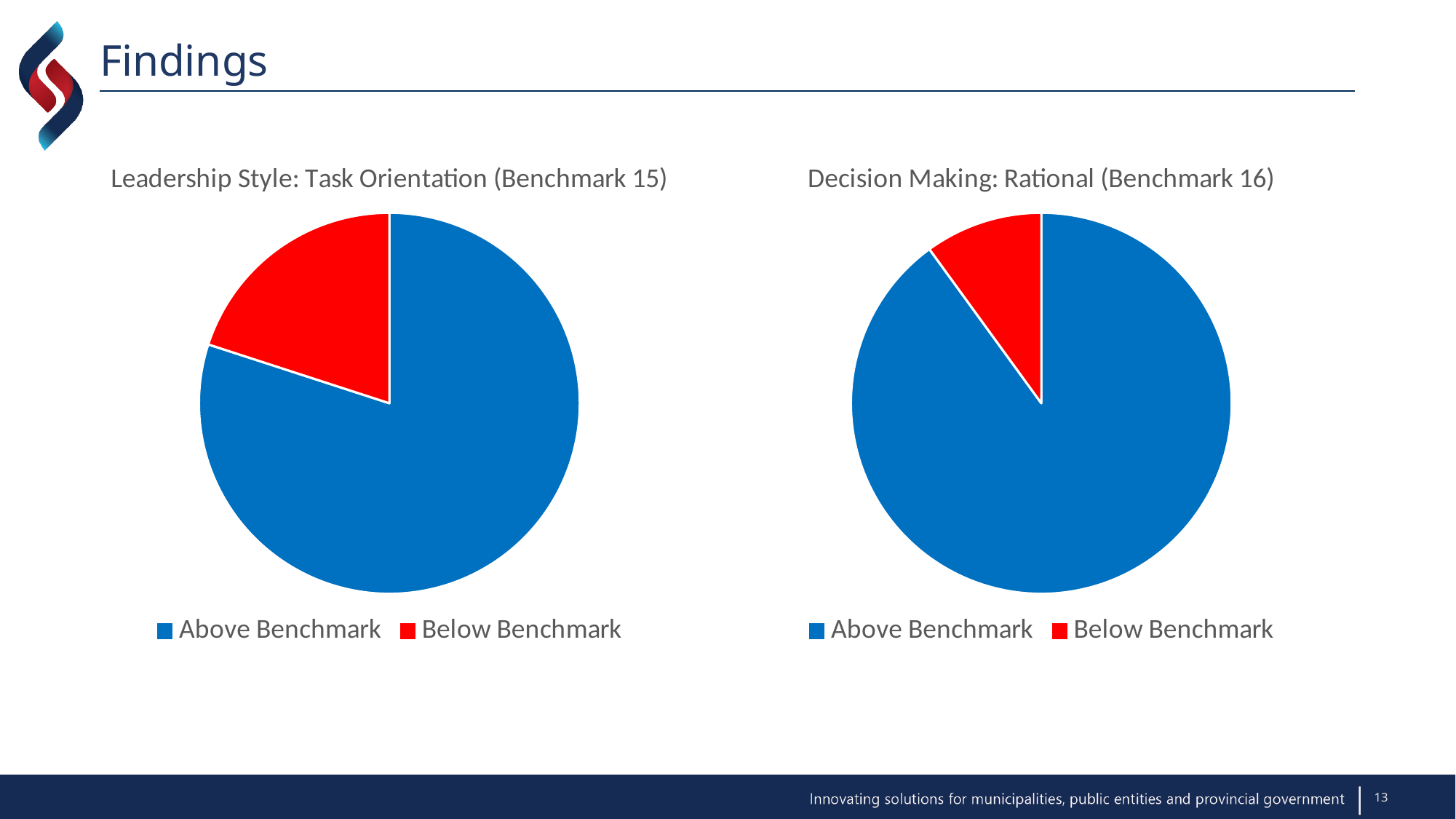
In the 'Decision Making: Rational (Benchmark 16)' chart, which slice is the largest? Above Benchmark What is the title of the pie chart on the right of the slide? Decision Making: Rational (Benchmark 16) What kind of chart is the 'Decision Making: Rational (Benchmark 16)' chart? pie chart In the 'Leadership Style: Task Orientation (Benchmark 15)' chart, which slice is the smallest? Below Benchmark How many entries does the legend of the 'Decision Making: Rational (Benchmark 16)' chart list? 2 In the 'Leadership Style: Task Orientation (Benchmark 15)' chart, which is larger, Above Benchmark or Below Benchmark? Above Benchmark In the 'Decision Making: Rational (Benchmark 16)' chart, which slice is the smallest? Below Benchmark What kind of chart is the 'Leadership Style: Task Orientation (Benchmark 15)' chart? pie chart In the 'Leadership Style: Task Orientation (Benchmark 15)' chart, which slice is the largest? Above Benchmark In the 'Decision Making: Rational (Benchmark 16)' chart, which is larger, Above Benchmark or Below Benchmark? Above Benchmark How many slices does the 'Leadership Style: Task Orientation (Benchmark 15)' pie chart have? 2 In the 'Leadership Style: Task Orientation (Benchmark 15)' chart, what colour is the Below Benchmark slice? red